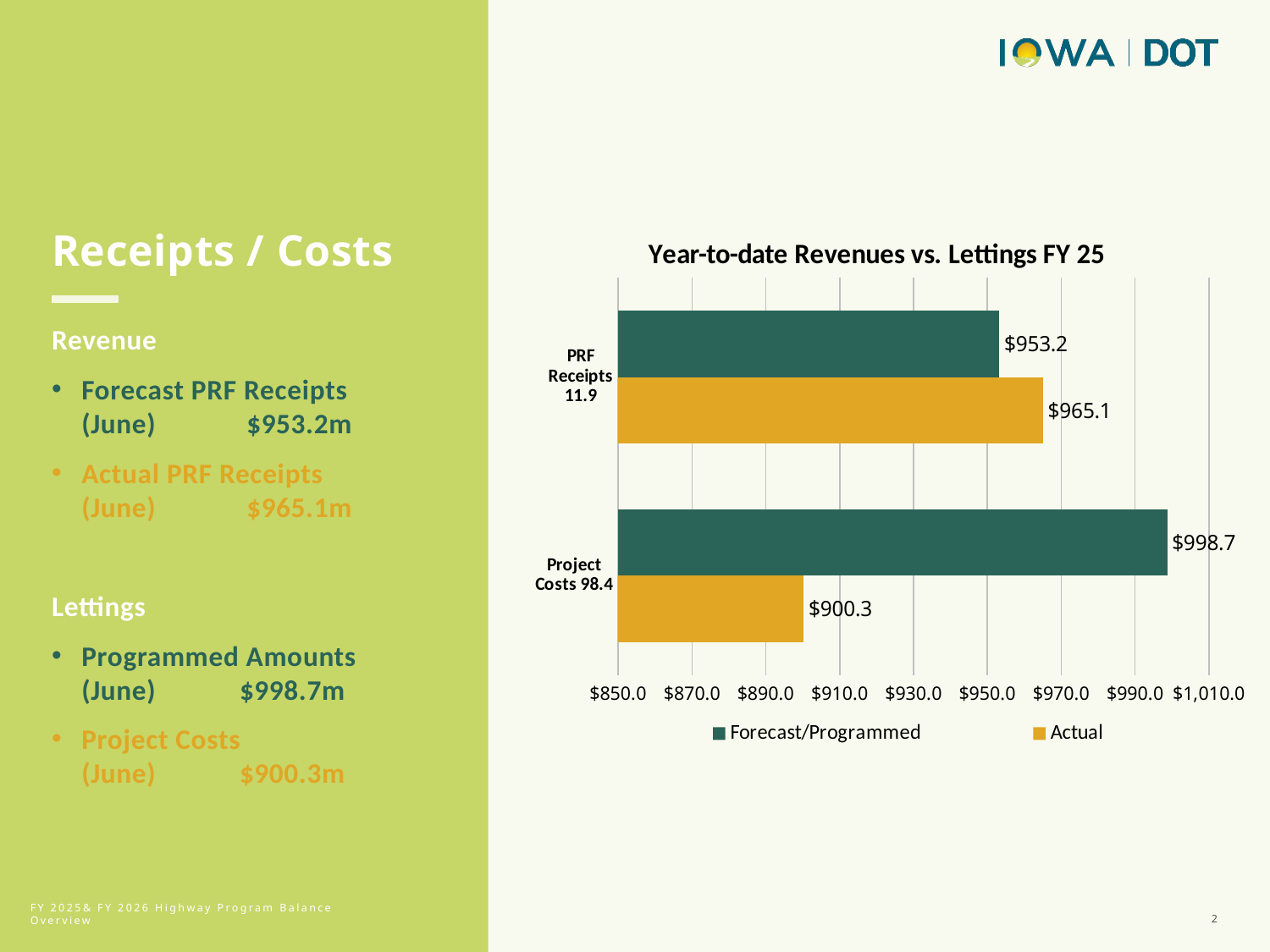
For Project Costs, which is larger: the Forecast/Programmed value or the Actual value? Forecast/Programmed What type of chart is shown on the slide? Bar chart What is the title of the chart? Year-to-date Revenues vs. Lettings FY 25 What is the Actual value for Project Costs? $900.3 What is the Forecast/Programmed value for Project Costs? $998.7 Which bar in the chart has the highest value? Project Costs, Forecast/Programmed ($998.7) Which bar in the chart has the lowest value? Project Costs, Actual ($900.3) What is the Actual value for PRF Receipts? $965.1 What is the difference between the Actual and Forecast/Programmed values for PRF Receipts? $11.9 How many series does the chart legend list? 2 What is the difference between the Forecast/Programmed and Actual values for Project Costs? $98.4 What is the Forecast/Programmed value for PRF Receipts? $953.2